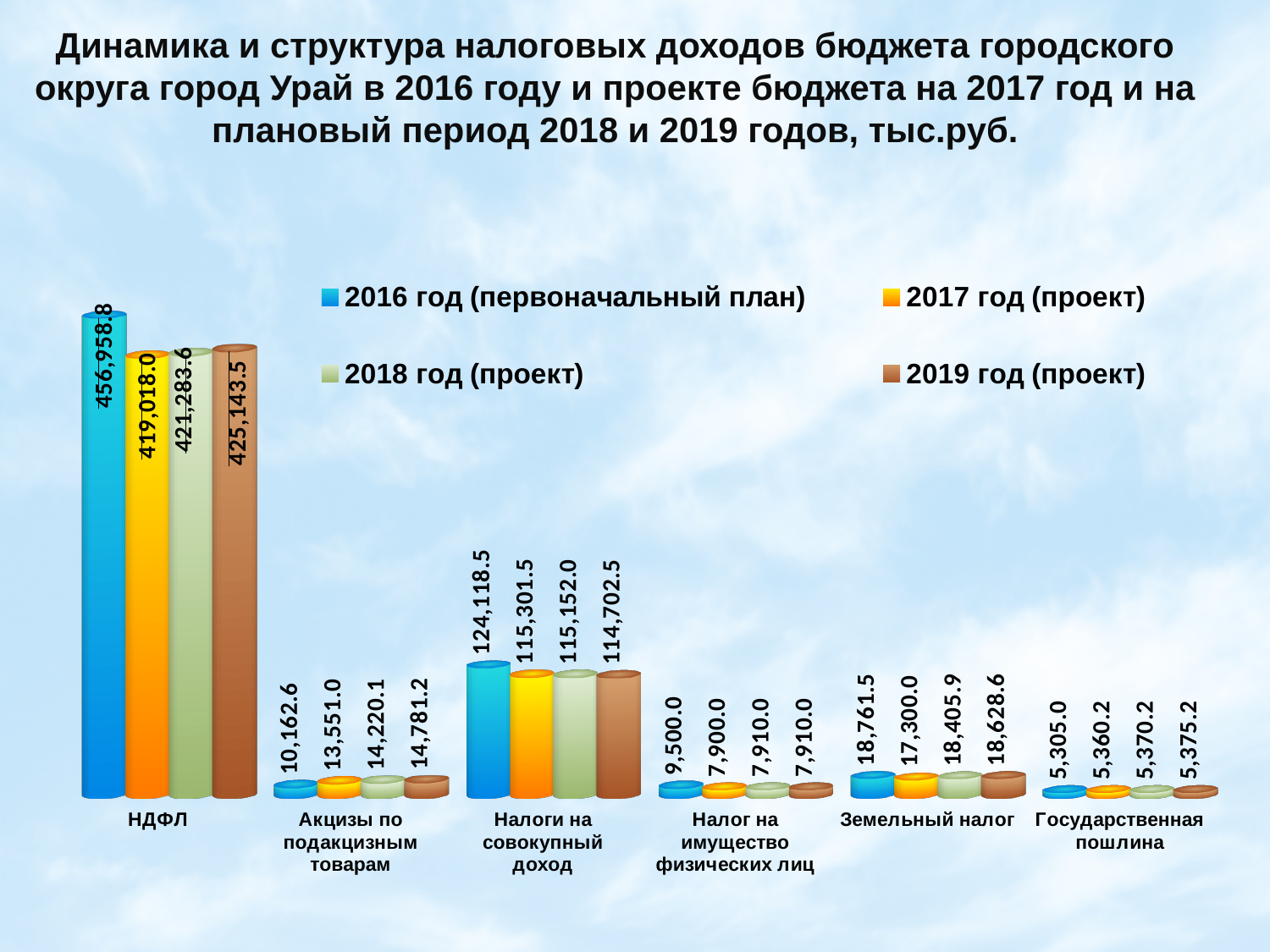
What is the value for Налоги на совокупный доход in the 2017 год (проект) series? 115,301.5 What is the difference between the 2019 год (проект) and 2016 год (первоначальный план) values for Акцизы по подакцизным товарам? 4,618.6 For Налог на имущество физических лиц, which is larger: the 2016 год (первоначальный план) value or the 2017 год (проект) value? 2016 год (первоначальный план) What is the value for Земельный налог in the 2019 год (проект) series? 18,628.6 Which category has the lowest value in the 2019 год (проект) series? Государственная пошлина What is the value for Государственная пошлина in the 2018 год (проект) series? 5,370.2 What kind of chart is shown on the slide? Bar chart Which category has the highest value in the 2016 год (первоначальный план) series? НДФЛ How many categories are shown on the x axis of the chart? 6 How many series does the legend list? 4 What is the difference between the 2016 год (первоначальный план) and 2017 год (проект) values for НДФЛ? 37,940.8 What is the value for НДФЛ in the 2016 год (первоначальный план) series? 456,958.8